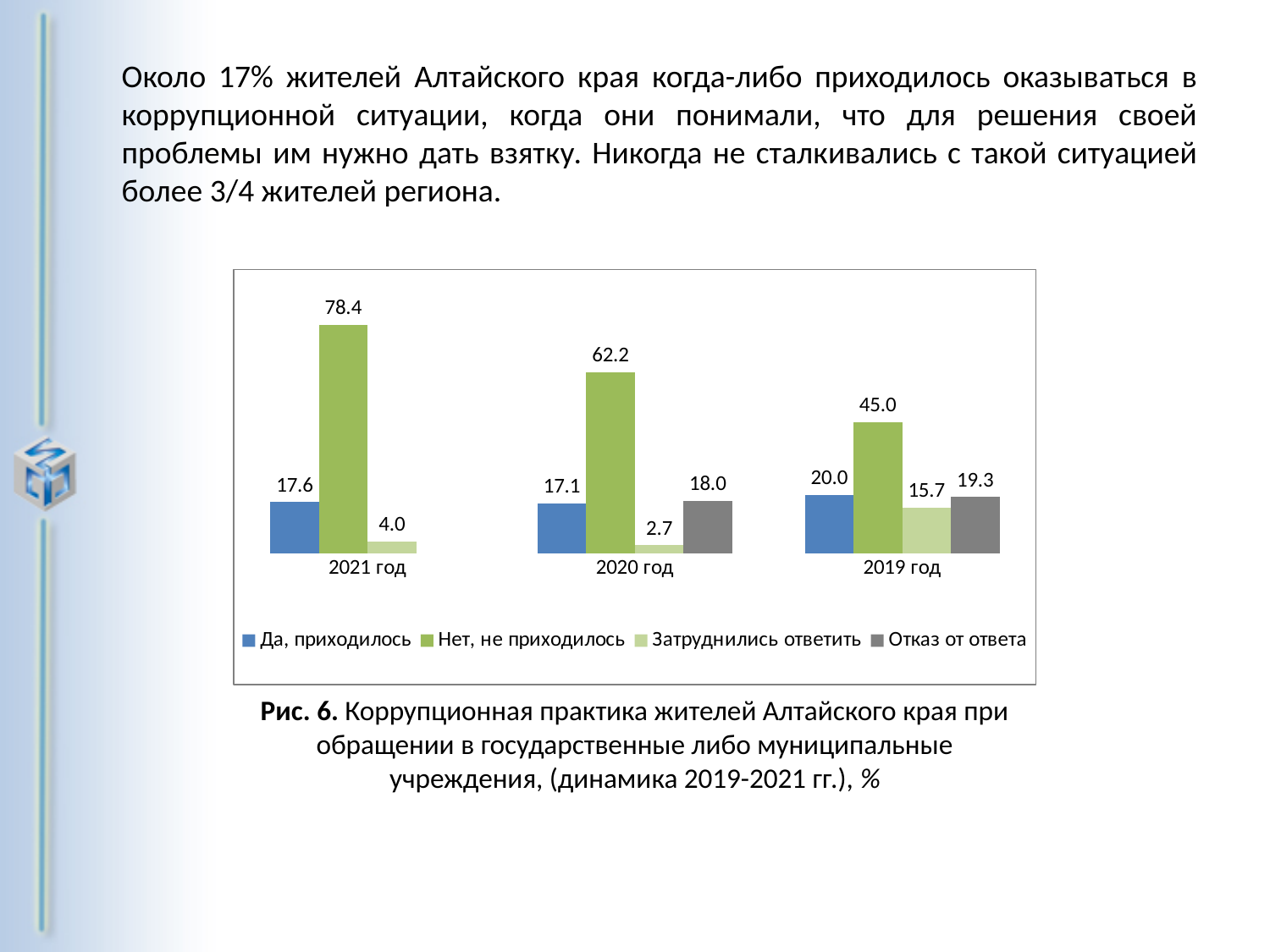
What is the value for "Да, приходилось" in 2020 год? 17.1 In which year is the value for "Нет, не приходилось" the highest? 2021 год Which is larger: "Да, приходилось" in 2019 год or "Отказ от ответа" in 2019 год? Да, приходилось in 2019 год What is the value for "Затруднились ответить" in 2020 год? 2.7 What is the value for "Нет, не приходилось" in 2021 год? 78.4 How many series does the legend list? 4 What is the value for "Отказ от ответа" in 2019 год? 19.3 In which year is the value for "Затруднились ответить" the lowest? 2020 год How many year categories are shown on the x axis? 3 What is the difference between the "Нет, не приходилось" values for 2021 год and 2020 год? 16.2 Does the value for "Нет, не приходилось" rise or fall from 2019 год to 2021 год? rise What kind of chart is shown on the slide? bar chart